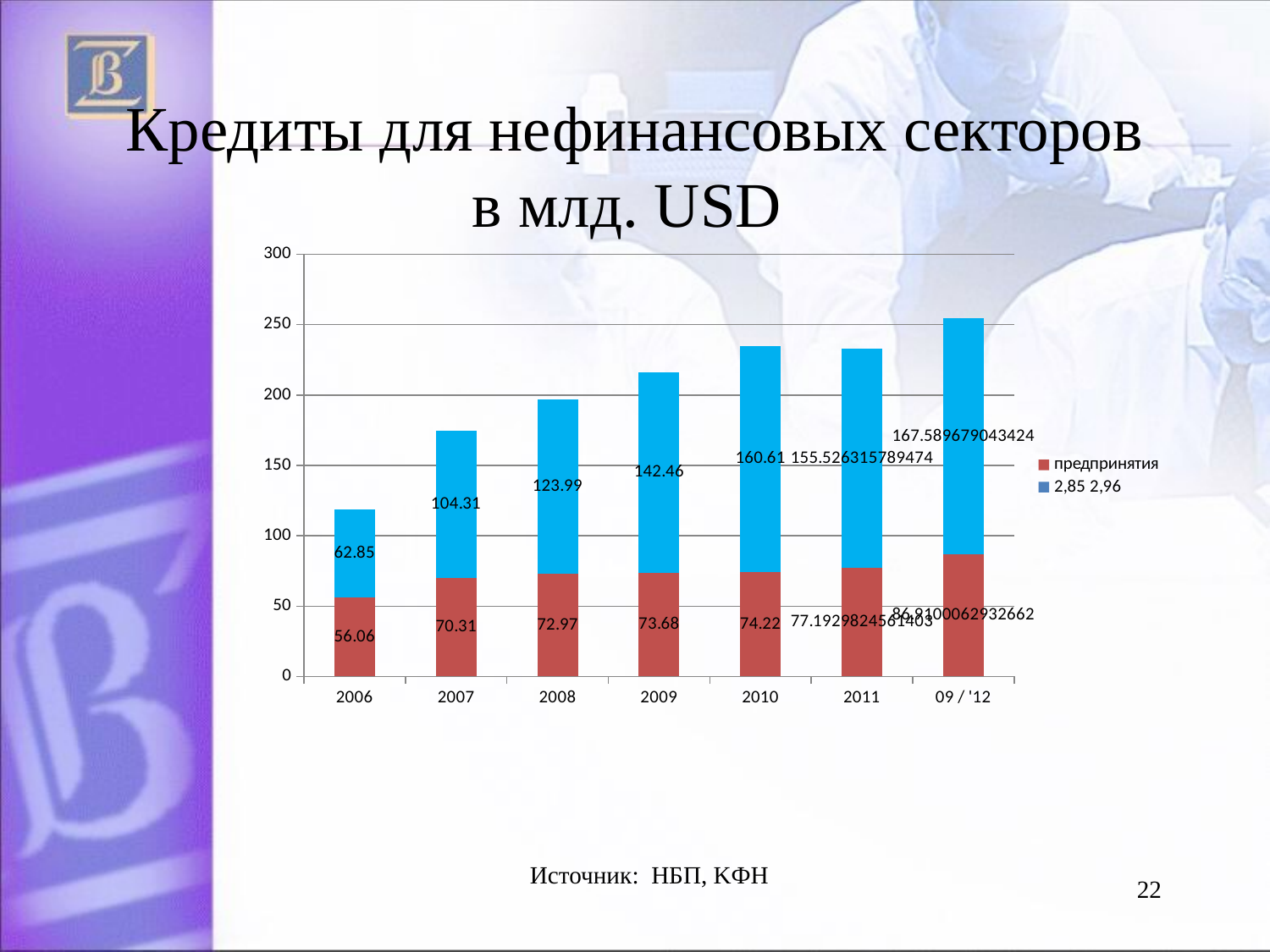
What kind of chart is shown on the slide? stacked bar chart How many categories are shown on the x axis of the chart? 7 What is the difference between the blue series values for 2008 and 2007? 19.68 In which category is the предпринятия series lowest? 2006 Is the total height of the stacked bar for 2009 greater or less than 200? greater What is the value of the предпринятия series for 2010? 74.22 What is the value of the blue series (2,85 2,96) for 2009? 142.46 How many series does the chart's legend list? 2 Which year has the larger value for the blue series, 2010 or 2011? 2010 What is the total of the stacked bar for 2006? 118.91 In which category is the blue series (2,85 2,96) highest? 09 / '12 What is the value of the предпринятия series for 2006? 56.06